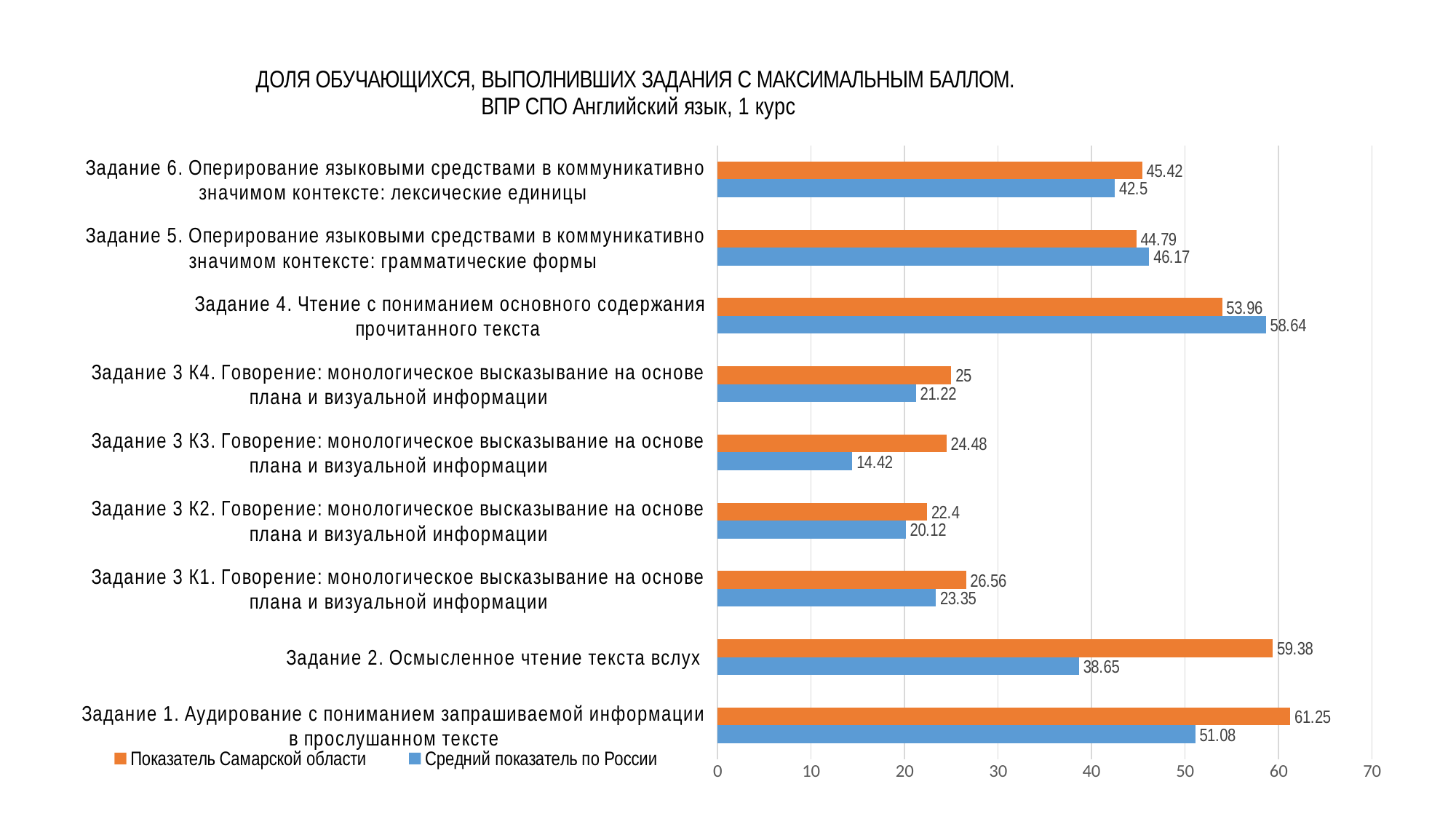
What type of chart is shown on the slide? Bar chart Is the value of Показатель Самарской области for Задание 4 greater or less than 50? greater What is the value of Средний показатель по России for Задание 2. Осмысленное чтение текста вслух? 38.65 How many task categories are shown on the chart? 9 What is the difference between Показатель Самарской области and Средний показатель по России for Задание 2. Осмысленное чтение текста вслух? 20.73 Which colour represents Средний показатель по России in the chart? Blue Which task has the lowest value for Средний показатель по России? Задание 3 К3. Говорение: монологическое высказывание на основе плана и визуальной информации Which task has the highest value for Показатель Самарской области? Задание 1. Аудирование с пониманием запрашиваемой информации в прослушанном тексте What is the value of Показатель Самарской области for Задание 1. Аудирование с пониманием запрашиваемой информации в прослушанном тексте? 61.25 For Задание 5 (грамматические формы), which is larger: Показатель Самарской области or Средний показатель по России? Средний показатель по России What is the value of Средний показатель по России for Задание 4. Чтение с пониманием основного содержания прочитанного текста? 58.64 How many series does the legend list? 2